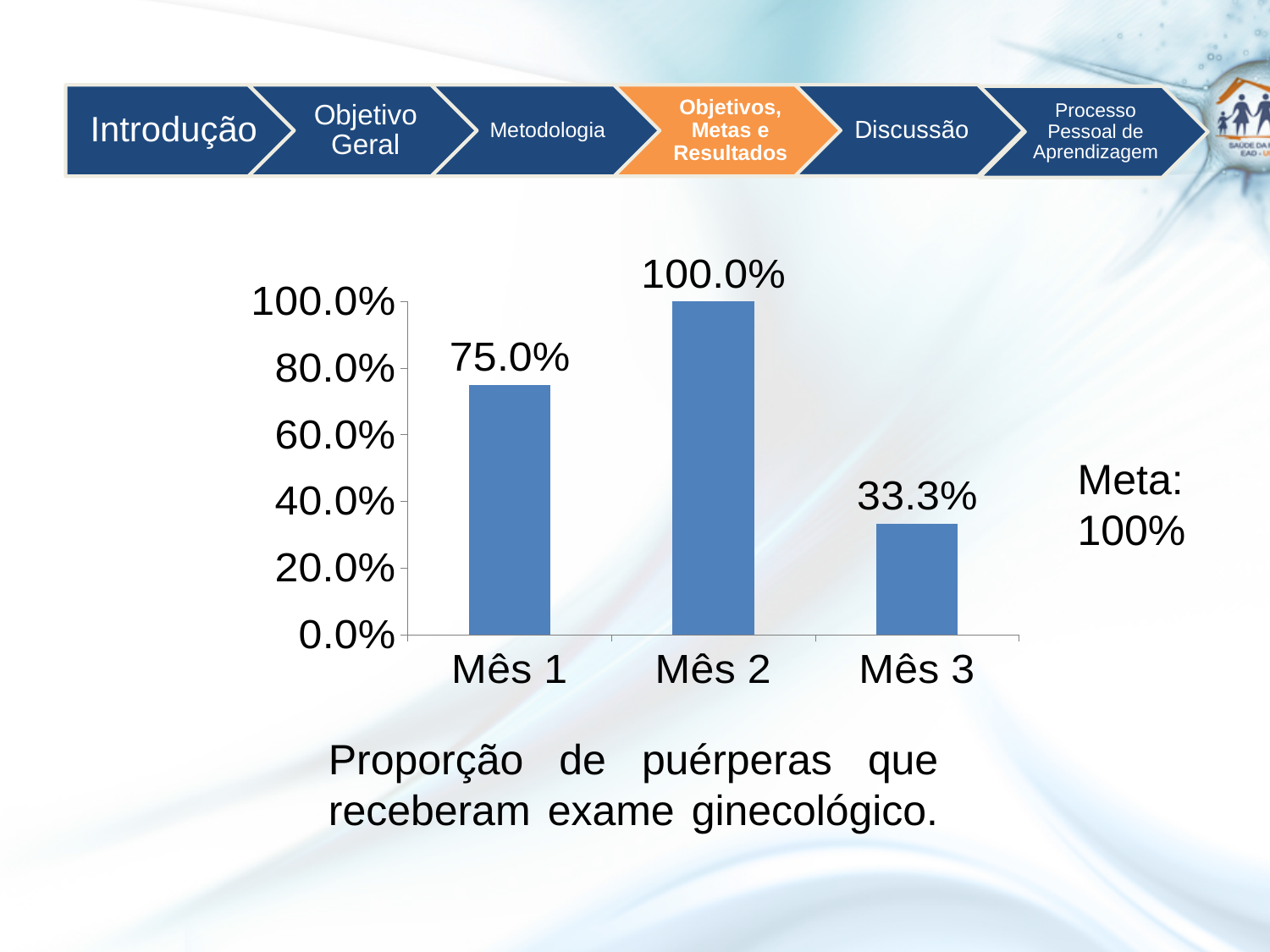
What is the value for Mês 1? 75.0% How many months are shown on the x axis? 3 Which month has the highest value? Mês 2 What kind of chart is shown on the slide? bar chart What is the value for Mês 2? 100.0% What is the difference between the values for Mês 2 and Mês 3? 66.7% What is the value for Mês 3? 33.3% Is the value for Mês 3 greater or less than 40.0%? less What is the difference between the values for Mês 1 and Mês 3? 41.7% Which is larger, the value for Mês 1 or the value for Mês 3? Mês 1 Which month has the lowest value? Mês 3 What is the target (Meta) stated next to the chart? 100%